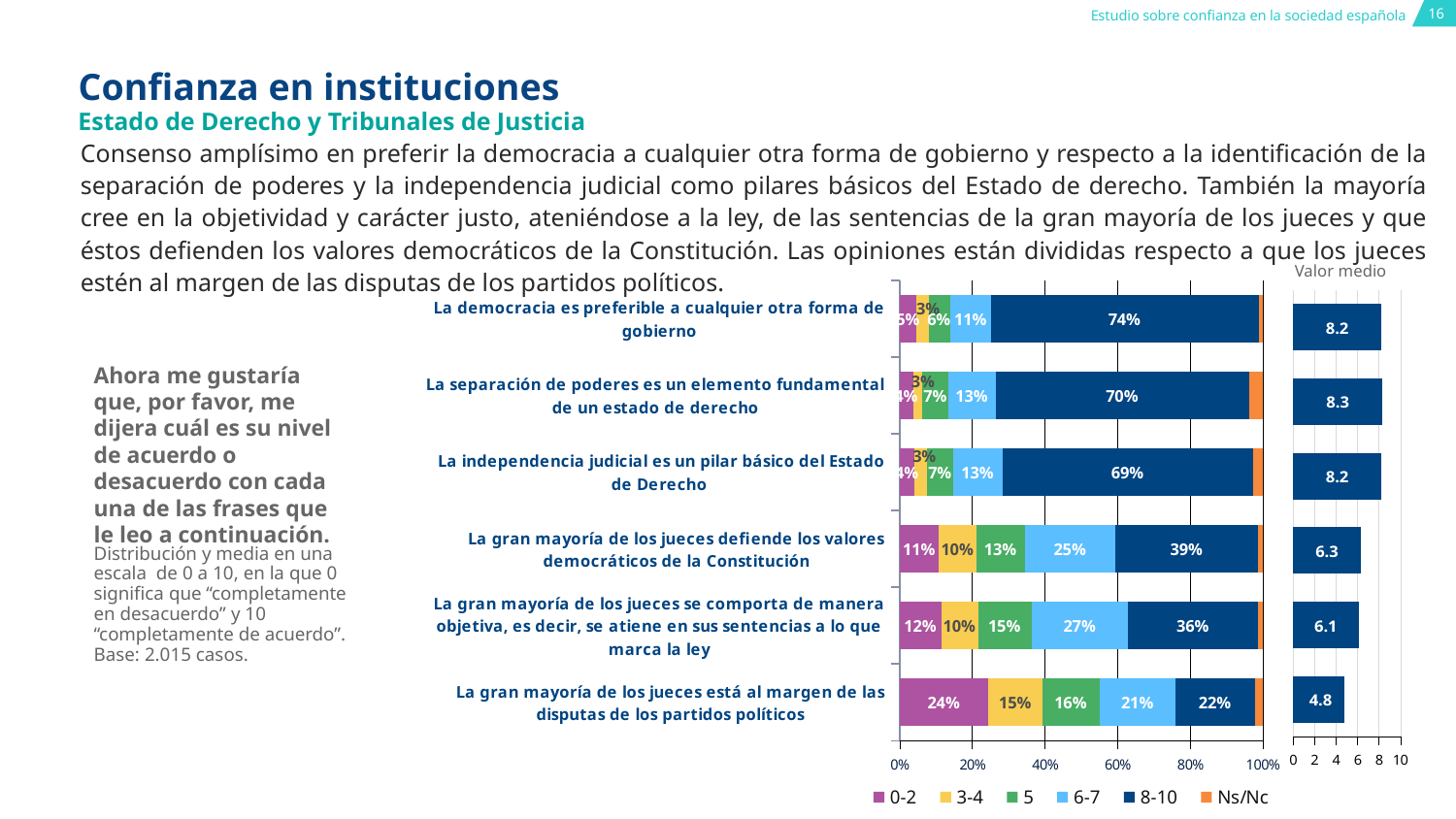
In the stacked bar chart, what percentage gave a score of 0-2 to "La gran mayoría de los jueces está al margen de las disputas de los partidos políticos"? 24% In the stacked bar chart, which statement has the largest 8-10 share? La democracia es preferible a cualquier otra forma de gobierno How many series does the legend of the stacked bar chart list? 6 What is the title of the small chart on the right showing the mean values? Valor medio What type of chart is used to show the distribution of responses on the slide? Stacked bar chart In the stacked bar chart, which is larger: the 6-7 share for "La gran mayoría de los jueces se comporta de manera objetiva..." or the 6-7 share for "La gran mayoría de los jueces defiende los valores democráticos de la Constitución"? La gran mayoría de los jueces se comporta de manera objetiva... How many statements (categories) are shown in the stacked bar chart? 6 In the stacked bar chart, what is the difference between the 8-10 share for "La gran mayoría de los jueces defiende los valores democráticos de la Constitución" and the 8-10 share for "La gran mayoría de los jueces se comporta de manera objetiva, es decir, se atiene en sus sentencias a lo que marca la ley"? 3% In the "Valor medio" chart, which statement has the lowest mean value? La gran mayoría de los jueces está al margen de las disputas de los partidos políticos In the stacked bar chart, what percentage gave a score of 8-10 to "La democracia es preferible a cualquier otra forma de gobierno"? 74% In the "Valor medio" chart, what is the mean value for "La separación de poderes es un elemento fundamental de un estado de derecho"? 8.3 In the "Valor medio" chart, which statement has the highest mean value? La separación de poderes es un elemento fundamental de un estado de derecho